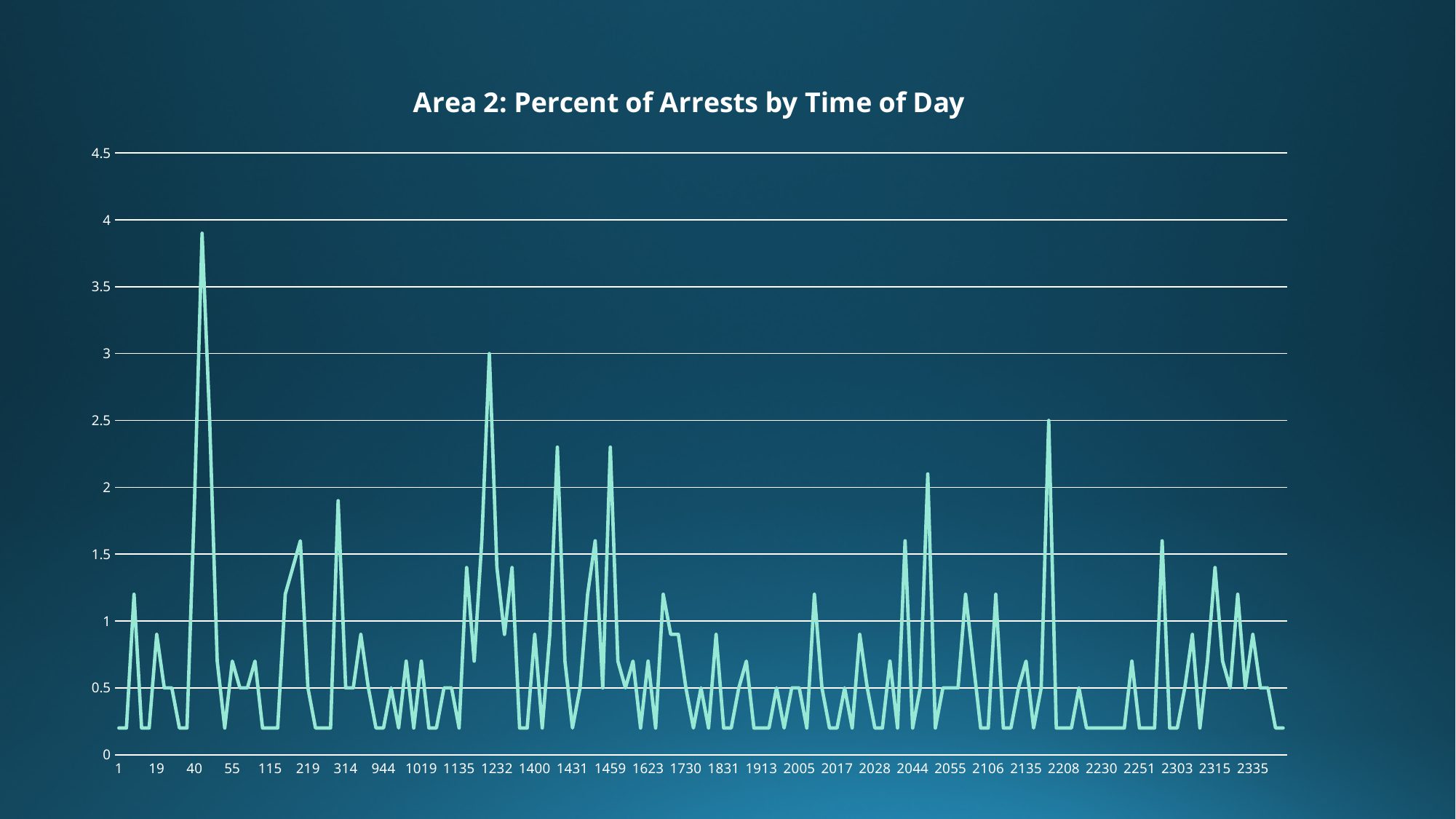
Is the highest value on the line greater or less than 3.5? greater What kind of chart is shown on the slide? line chart Is the lowest value on the line greater or less than 0.5? less Is the value for the first x-axis category, 1, greater or less than 0.5? less Does the line show a steady rising or falling trend across the x axis, or does it fluctuate? fluctuates What is the title of the chart? Area 2: Percent of Arrests by Time of Day What is the highest value shown on the y axis? 4.5 How many lines (series) are plotted on the chart? 1 How many labels are printed along the x axis? 31